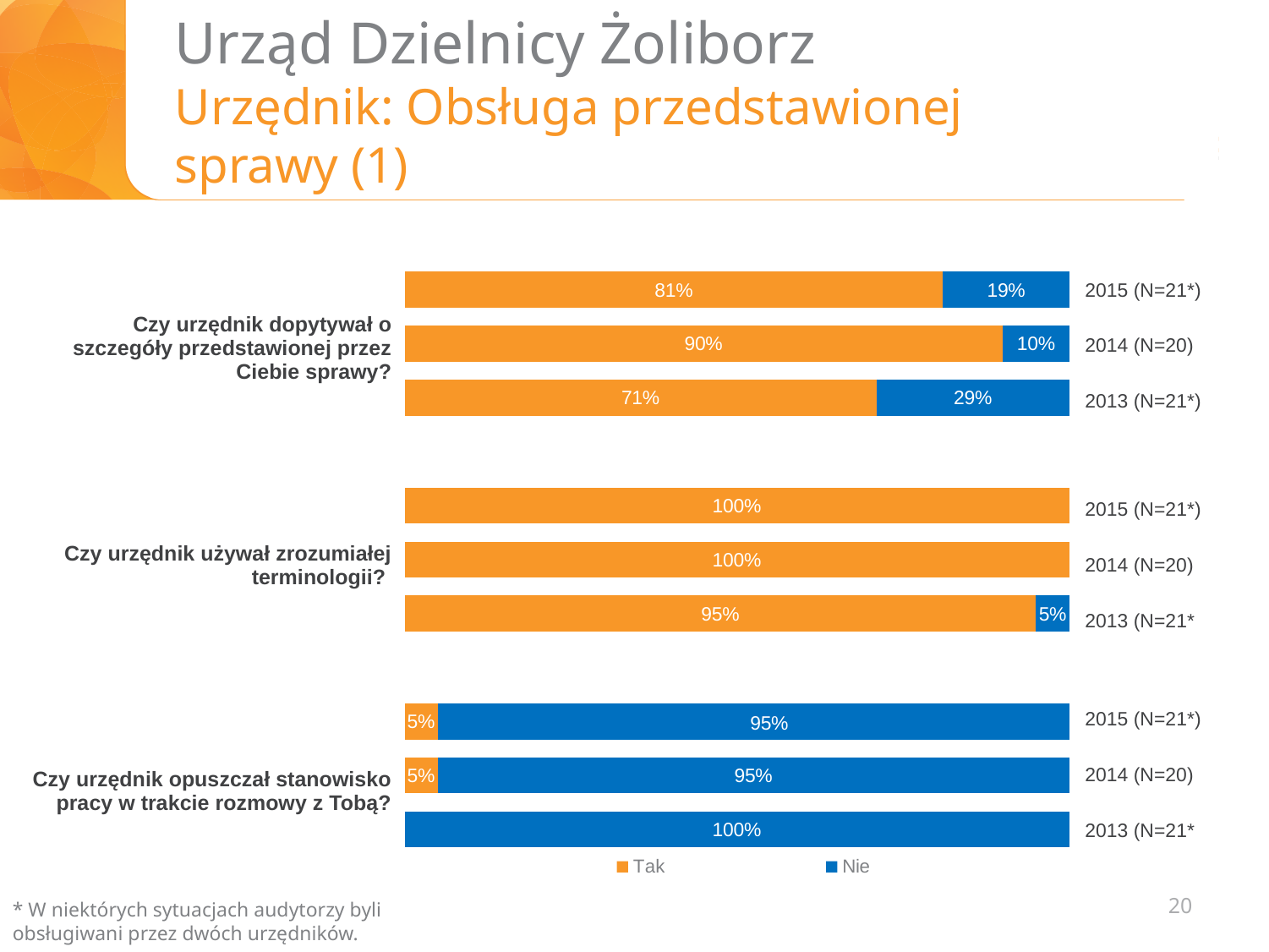
What is the 'Tak' value for 2013 (N=21*) for the question 'Czy urzędnik używał zrozumiałej terminologii?' 95% What is the 'Nie' value for 2013 (N=21*) for the question 'Czy urzędnik opuszczał stanowisko pracy w trakcie rozmowy z Tobą?' 100% How many bars are plotted on the chart in total? 9 For the question 'Czy urzędnik dopytywał o szczegóły przedstawionej przez Ciebie sprawy?', what is the difference between the 'Tak' values for 2014 (N=20) and 2013 (N=21*)? 19 percentage points What are the two series named in the legend? Tak and Nie For the question 'Czy urzędnik opuszczał stanowisko pracy w trakcie rozmowy z Tobą?', is the 'Tak' value for 2015 (N=21*) larger or smaller than the 'Nie' value for the same year? smaller What is the 'Nie' value for 2013 (N=21*) for the question 'Czy urzędnik dopytywał o szczegóły przedstawionej przez Ciebie sprawy?' 29% What kind of chart is shown on the slide? stacked bar chart For the question 'Czy urzędnik dopytywał o szczegóły przedstawionej przez Ciebie sprawy?', which year has the highest 'Tak' share? 2014 (N=20) How many series does the legend list? 2 What is the 'Tak' value for 2015 (N=21*) for the question 'Czy urzędnik dopytywał o szczegóły przedstawionej przez Ciebie sprawy?' 81% For the question 'Czy urzędnik używał zrozumiałej terminologii?', which year has the lowest 'Tak' share? 2013 (N=21*)